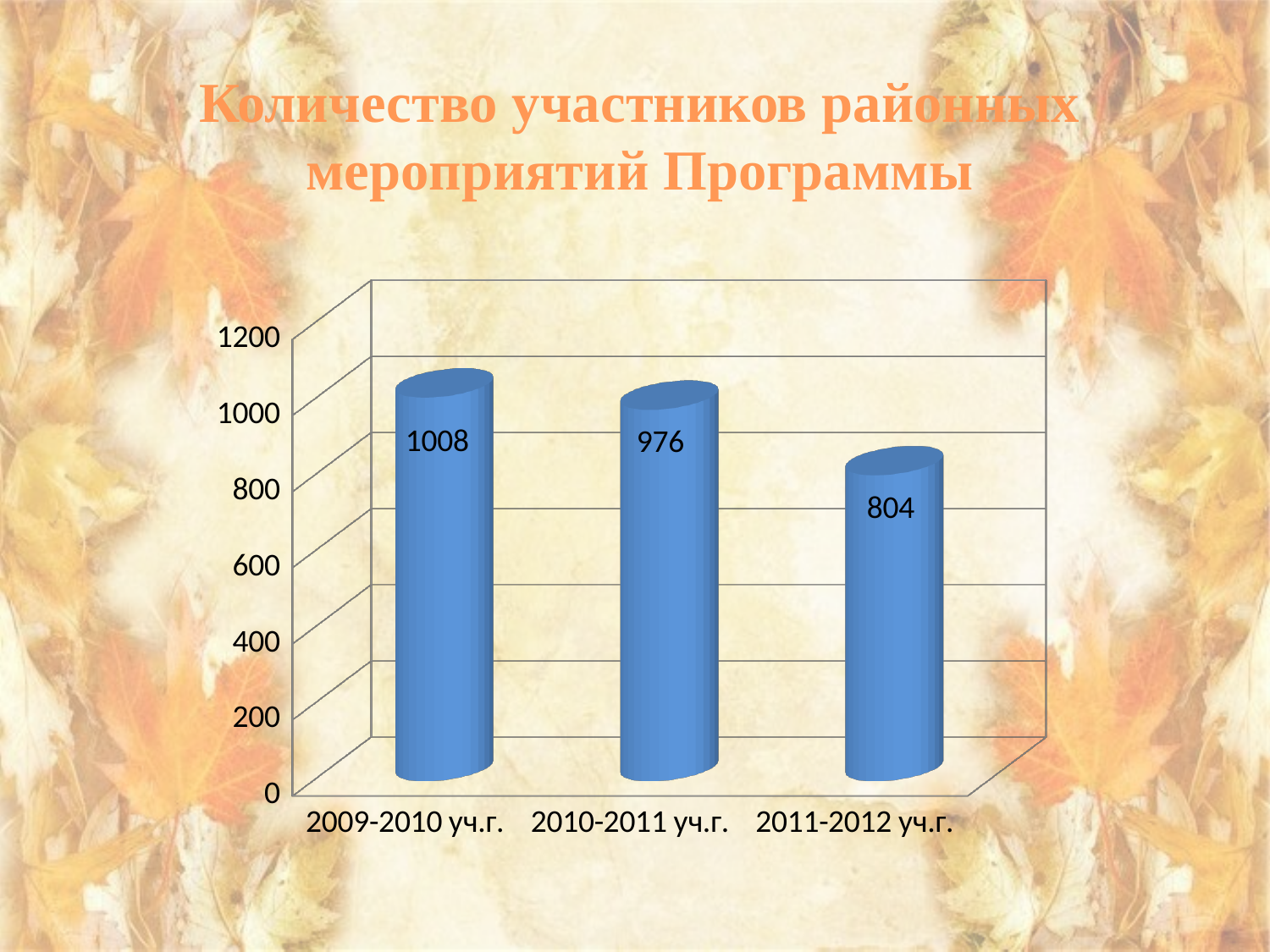
What is the value for 2011-2012 уч.г.? 804 Which category has the highest value? 2009-2010 уч.г. Do the values rise or fall from 2009-2010 уч.г. to 2011-2012 уч.г.? fall What is the difference between the values for 2009-2010 уч.г. and 2010-2011 уч.г.? 32 What is the difference between the values for 2009-2010 уч.г. and 2011-2012 уч.г.? 204 How many categories are shown on the x axis? 3 What kind of chart is shown on the slide? bar chart Which is larger, the value for 2010-2011 уч.г. or 2011-2012 уч.г.? 2010-2011 уч.г. Which category has the lowest value? 2011-2012 уч.г. What is the value for 2009-2010 уч.г.? 1008 Is the value for 2011-2012 уч.г. greater or less than 1000? less What is the value for 2010-2011 уч.г.? 976